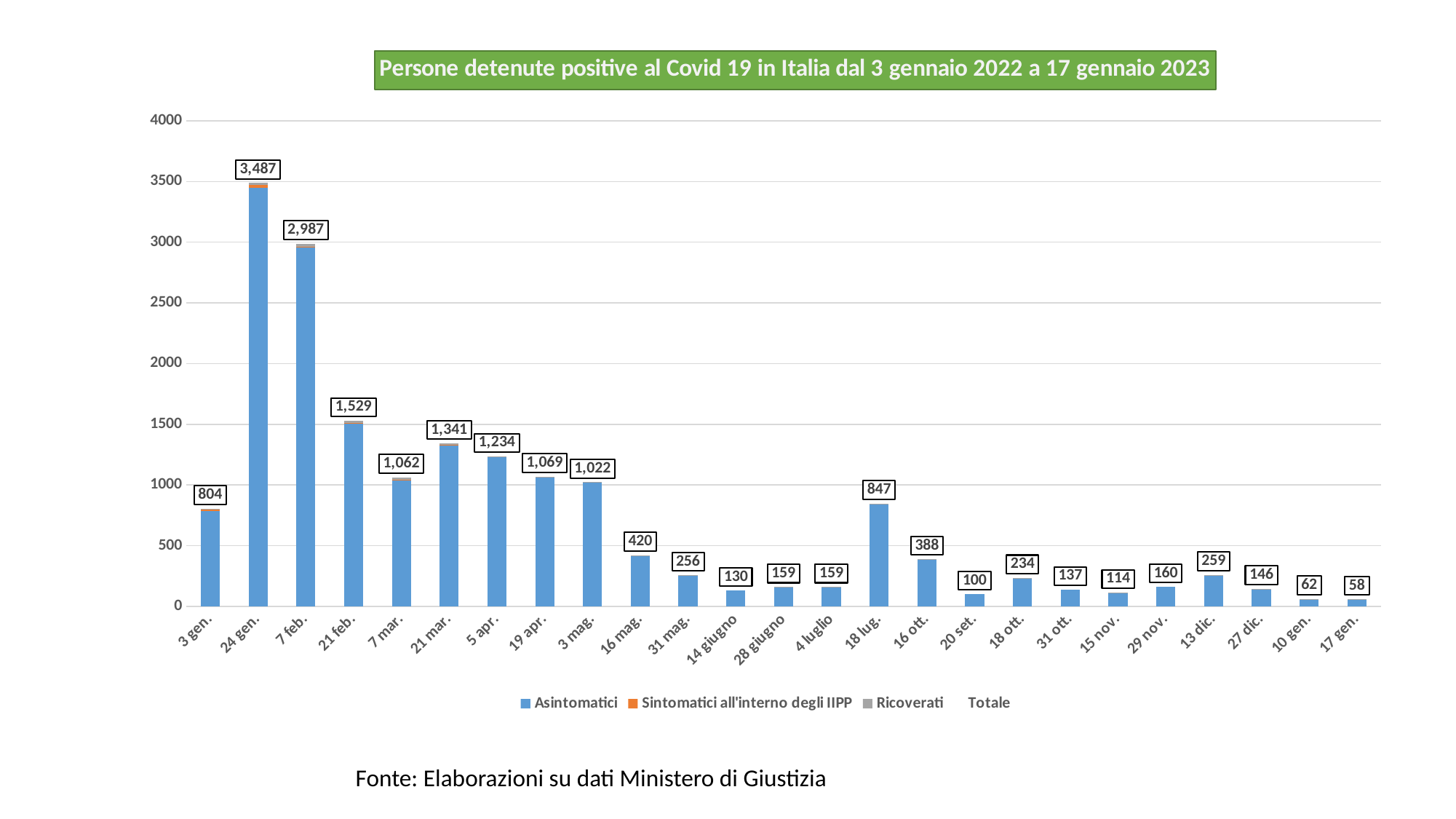
Is the total for 21 feb. greater or less than 1500? greater Which date has the highest total? 24 gen. Which has a larger total, 16 ott. or 13 dic.? 16 ott. What kind of chart is shown? Stacked bar chart What is the total value shown for 24 gen.? 3,487 How many dates are shown on the x axis? 25 What is the difference between the totals for 24 gen. and 7 feb.? 500 What is the title of the chart? Persone detenute positive al Covid 19 in Italia dal 3 gennaio 2022 a 17 gennaio 2023 What is the total value shown for 17 gen.? 58 What is the total value shown for 18 lug.? 847 Which date has the lowest total? 17 gen. How many entries does the legend list? 4